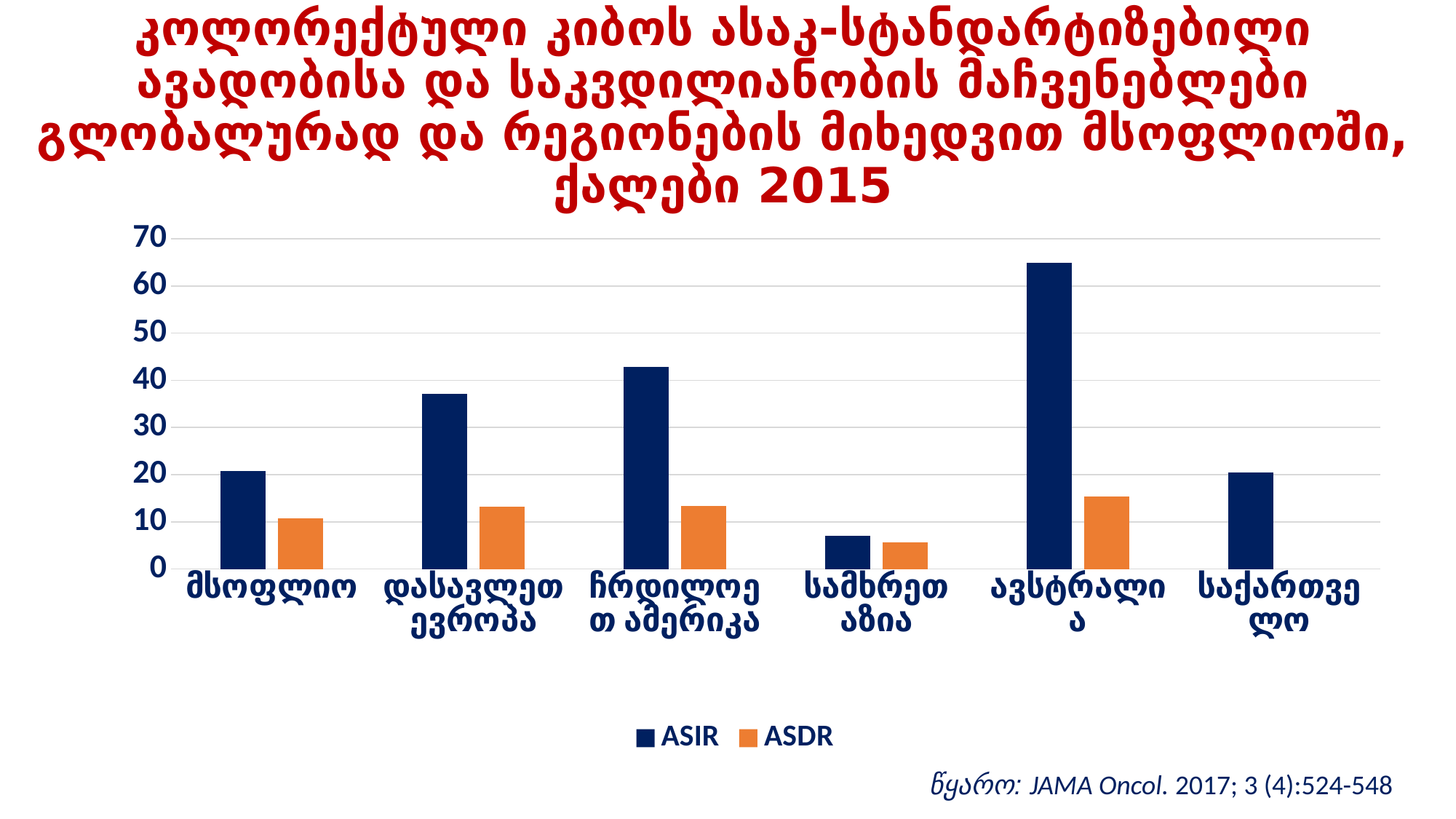
Which category has the highest ASIR value? ავსტრალია Which category has the lowest ASIR value? სამხრეთ აზია What kind of chart is shown on the slide? bar chart How many series does the legend list? 2 Which category has the highest ASDR value? ავსტრალია Is the ASIR value for სამხრეთ აზია greater or less than 10? less Which category has no ASDR bar plotted? საქართველო Is the ASIR value for ჩრდილოეთ ამერიკა greater or less than 40? greater Is the ASIR value for ავსტრალია greater or less than 60? greater How many categories are shown on the x axis? 6 Which series is shown in orange in the legend? ASDR Which is larger, the ASIR value for დასავლეთ ევროპა or the ASIR value for მსოფლიო? დასავლეთ ევროპა